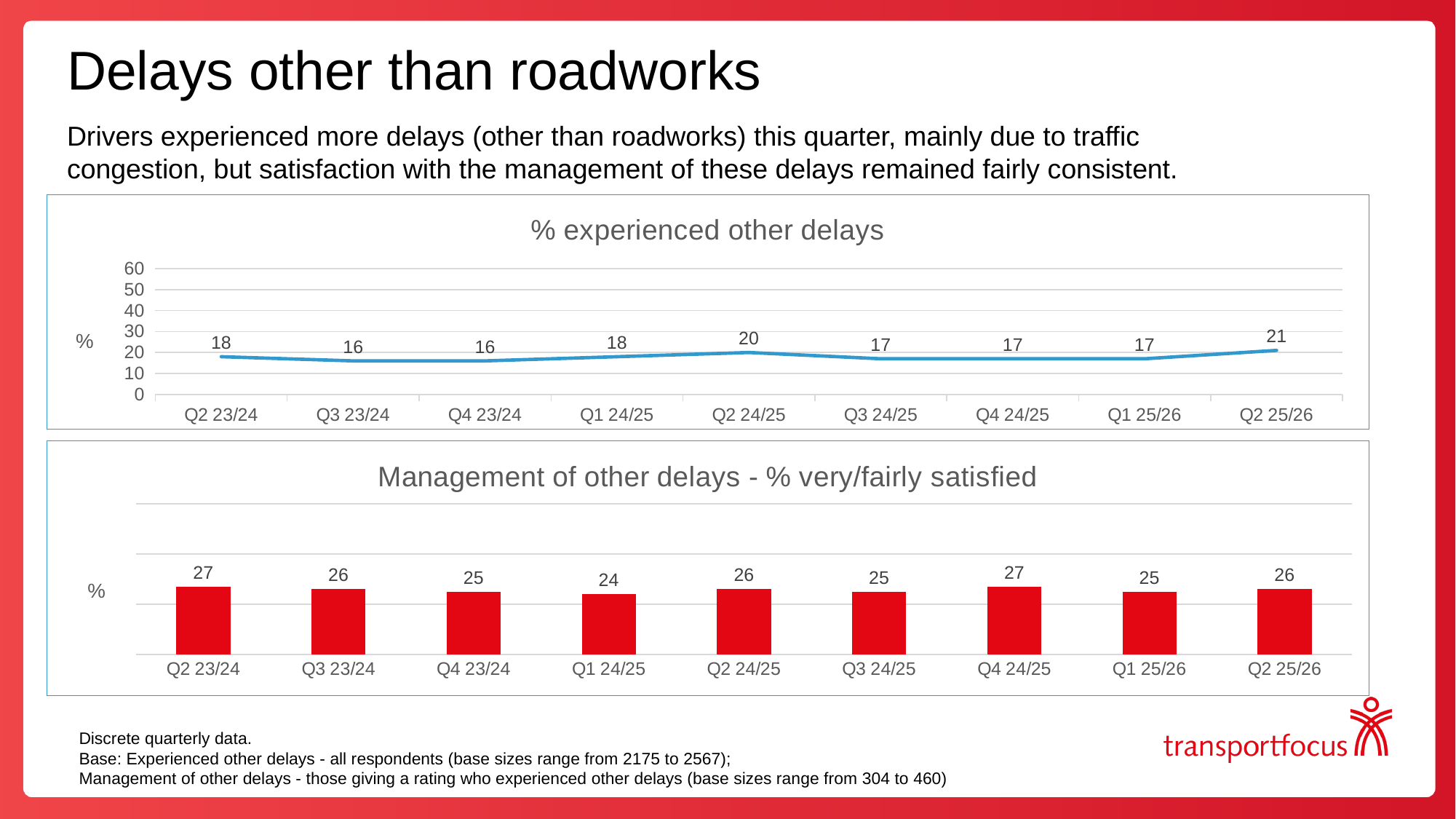
What kind of chart is the '% experienced other delays' chart? Line chart In the '% experienced other delays' chart, what is the difference between Q2 25/26 and Q1 25/26? 4 In the 'Management of other delays - % very/fairly satisfied' chart, which is larger: Q2 23/24 or Q4 23/24? Q2 23/24 In the '% experienced other delays' chart, what is the value for Q2 24/25? 20 In the '% experienced other delays' chart, what is the value for Q2 25/26? 21 What kind of chart is the 'Management of other delays - % very/fairly satisfied' chart? Bar chart In the '% experienced other delays' chart, how many quarters are plotted? 9 In the 'Management of other delays - % very/fairly satisfied' chart, which quarter has the lowest value? Q1 24/25 In the 'Management of other delays - % very/fairly satisfied' chart, what is the difference between Q2 23/24 and Q1 24/25? 3 In the '% experienced other delays' chart, is the value for Q3 23/24 greater or less than 30? less In the 'Management of other delays - % very/fairly satisfied' chart, what is the value for Q1 24/25? 24 In the '% experienced other delays' chart, which quarter has the highest value? Q2 25/26